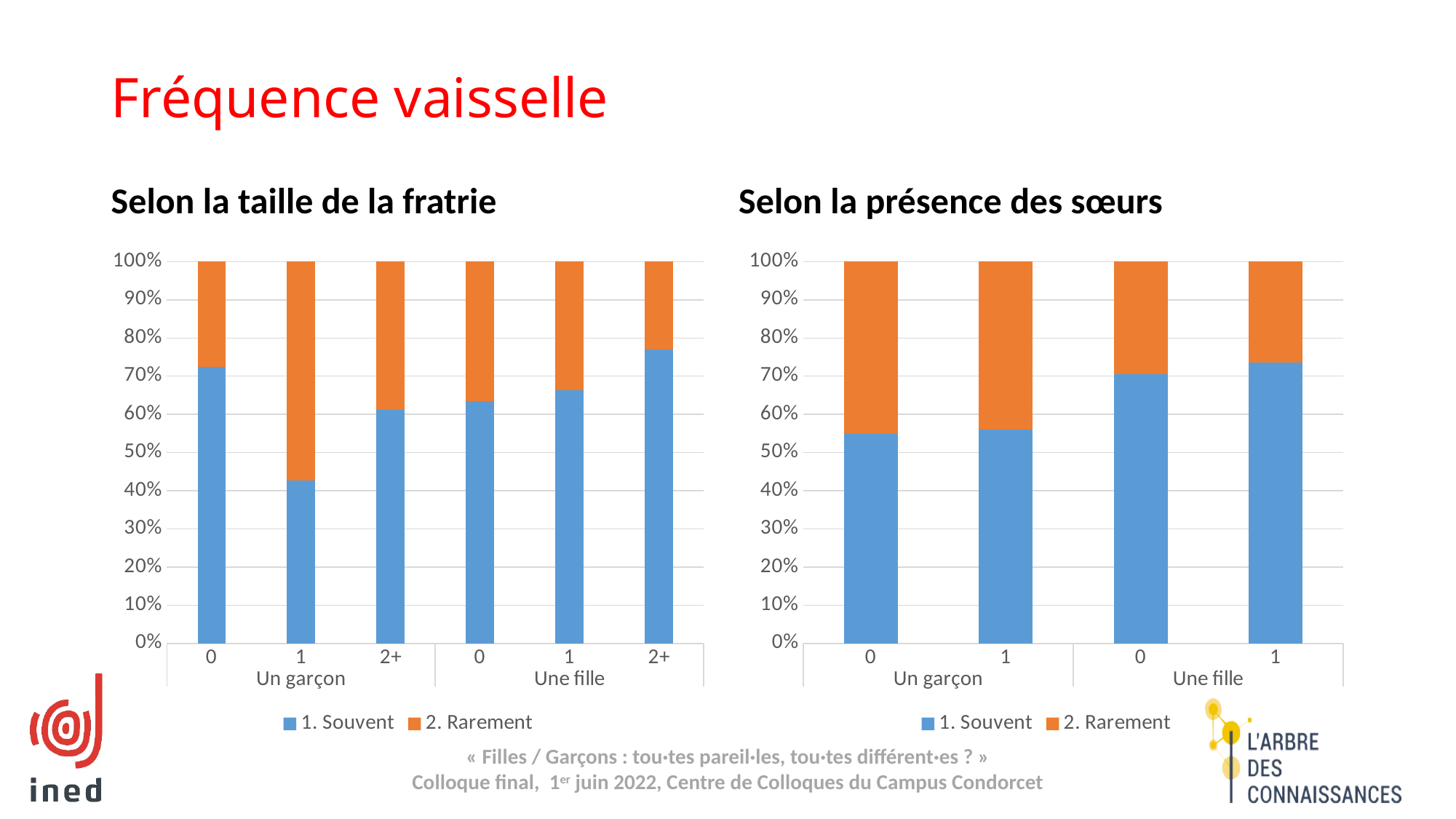
In the chart titled "Selon la présence des sœurs", is the "1. Souvent" share for "0" under "Un garçon" greater or less than 50%? greater In the chart titled "Selon la taille de la fratrie", is the "1. Souvent" share for "1" under "Un garçon" greater or less than 50%? less In the chart titled "Selon la taille de la fratrie", is the "1. Souvent" share for "0" under "Un garçon" greater or less than 60%? greater In the chart titled "Selon la taille de la fratrie", which bar has the lowest share of "1. Souvent"? 1 (Un garçon) In the chart titled "Selon la taille de la fratrie", which is larger: the "2. Rarement" share for "1" under "Un garçon" or for "2+" under "Une fille"? 1 (Un garçon) How many bars are plotted in the chart titled "Selon la taille de la fratrie"? 6 In the chart titled "Selon la présence des sœurs", which is larger: the "1. Souvent" share for "1" under "Un garçon" or for "1" under "Une fille"? 1 (Une fille) What are the two legend entries in the chart titled "Selon la taille de la fratrie"? 1. Souvent and 2. Rarement How many bars are plotted in the chart titled "Selon la présence des sœurs"? 4 What kind of chart is the chart titled "Selon la taille de la fratrie"? Stacked bar chart How many series does the legend list in the chart titled "Selon la présence des sœurs"? 2